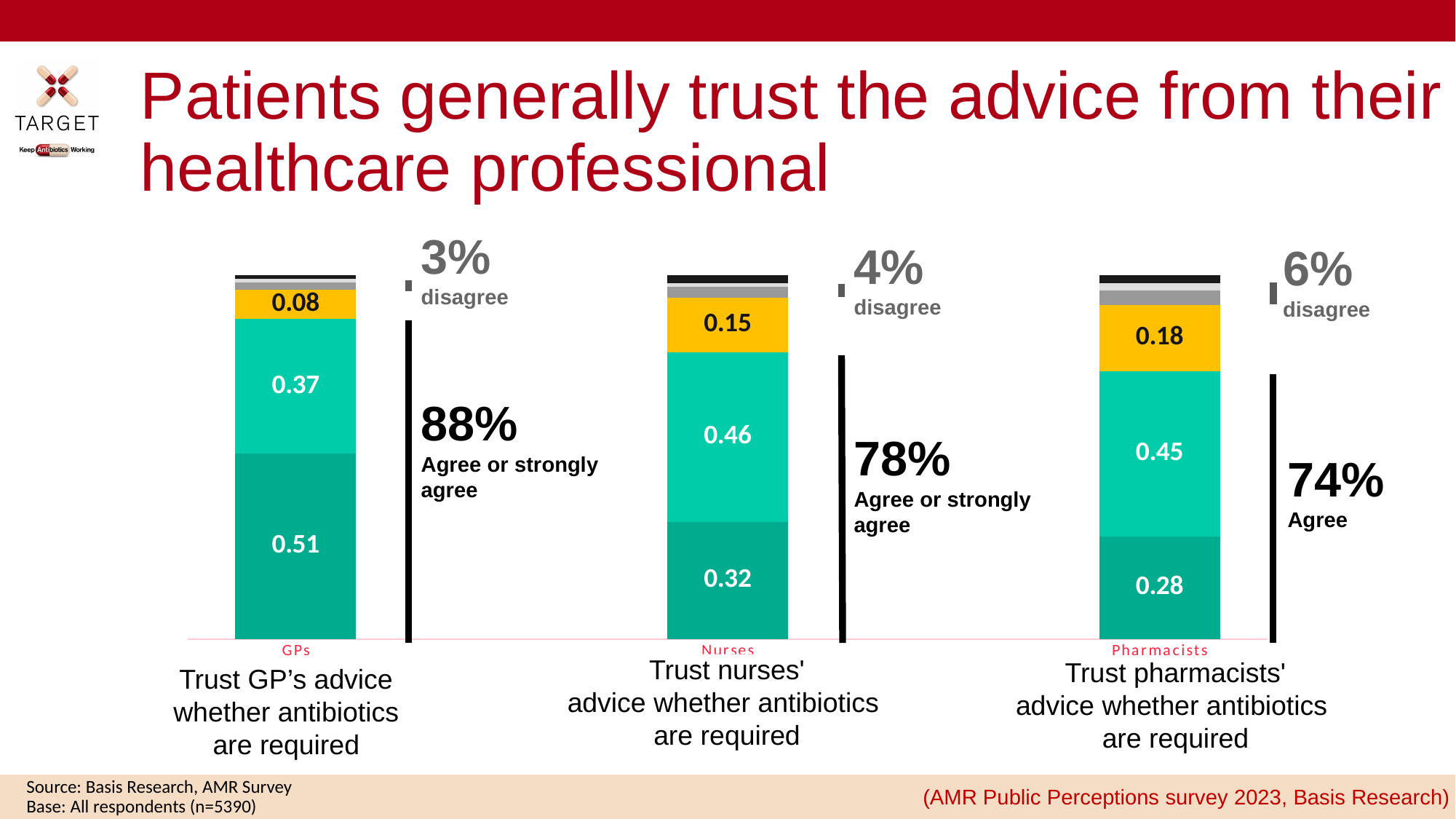
What kind of chart is shown on the slide? Stacked bar chart What is the difference between the bottom dark teal segment of the GPs bar and that of the Pharmacists bar? 0.23 Which is larger: the bottom dark teal segment of the GPs bar or of the Nurses bar? GPs In the Nurses bar, what is the value of the middle (light teal) segment? 0.46 What is the difference between the light teal segment of the Nurses bar and that of the GPs bar? 0.09 In the GPs bar, what is the value of the bottom (dark teal) segment? 0.51 How many stacked bars are shown on the slide? 3 Which bar (GPs, Nurses or Pharmacists) has the smallest yellow segment? GPs Which bar (GPs, Nurses or Pharmacists) has the largest bottom dark teal segment? GPs In the Pharmacists bar, what is the value of the yellow segment? 0.18 Do the values of the bottom dark teal segments rise or fall from GPs to Nurses to Pharmacists? Fall What percentage is annotated as 'Agree or strongly agree' next to the Nurses bar? 78%